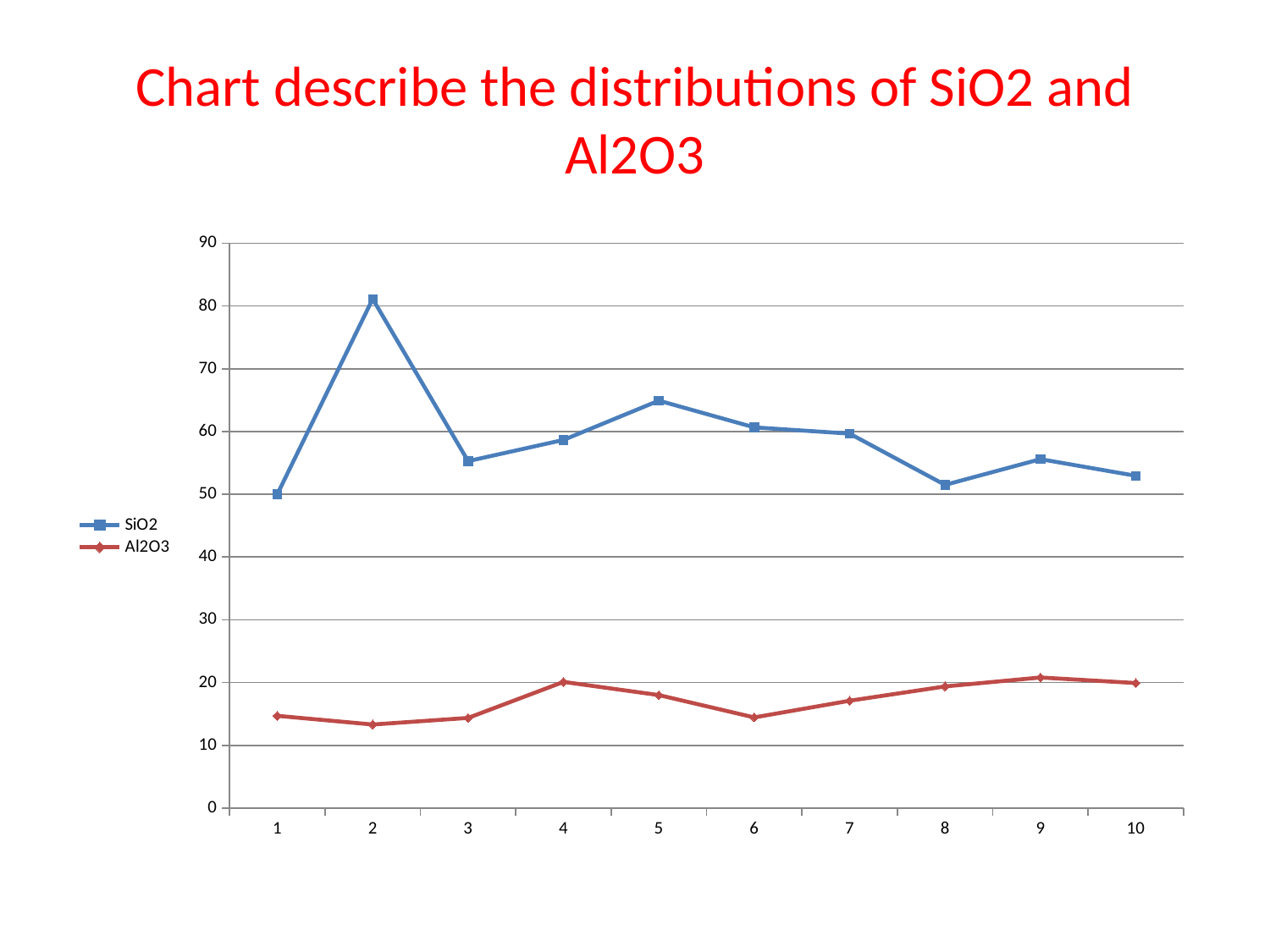
At which x-axis point does SiO2 reach its highest value? 2 Is the Al2O3 value at point 1 greater or less than 10? greater What kind of chart is shown on the slide? line chart How many series does the legend list? 2 Which two series are listed in the legend? SiO2 and Al2O3 Which is larger, the SiO2 value at point 2 or at point 3? point 2 Is the SiO2 value at point 8 greater or less than 60? less Does the SiO2 line rise or fall from point 5 to point 8? fall Is the Al2O3 value at point 6 greater or less than 20? less Which is larger, the Al2O3 value at point 4 or at point 2? point 4 How many points are plotted along the x axis for each series? 10